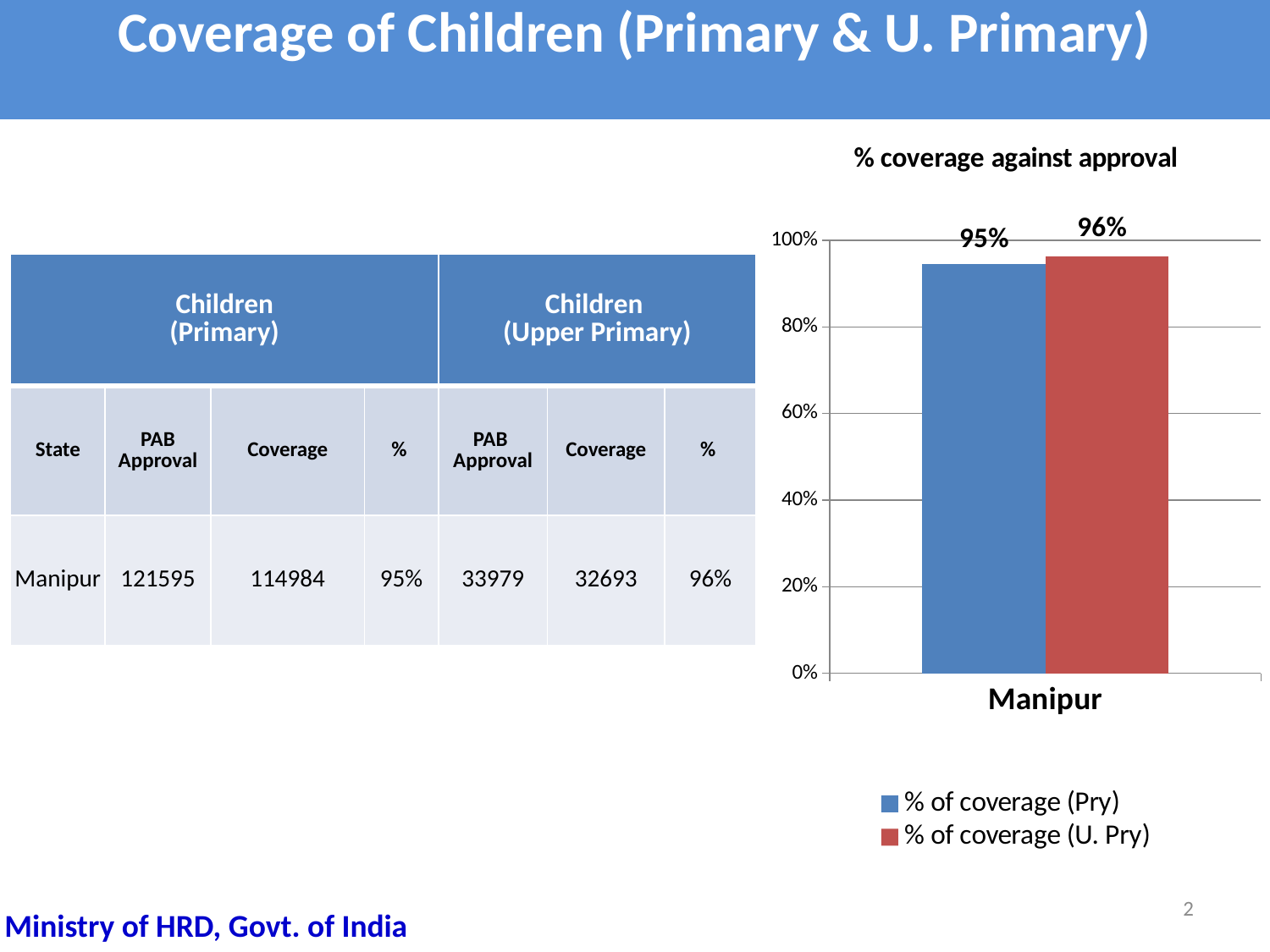
What is the title of the chart? % coverage against approval What is the value of % of coverage (Pry) for Manipur? 95% How many series does the chart legend list? 2 Which series has the higher value for Manipur, % of coverage (Pry) or % of coverage (U. Pry)? % of coverage (U. Pry) What is the difference between % of coverage (U. Pry) and % of coverage (Pry) for Manipur? 1% Which colour represents % of coverage (U. Pry) in the chart? red What kind of chart is shown on the slide? bar chart Is the value of % of coverage (U. Pry) for Manipur greater or less than 100%? less What is the value of % of coverage (U. Pry) for Manipur? 96% What is the category label on the x axis of the chart? Manipur Is the value of % of coverage (Pry) for Manipur greater or less than 80%? greater How many categories are shown on the x axis of the chart? 1